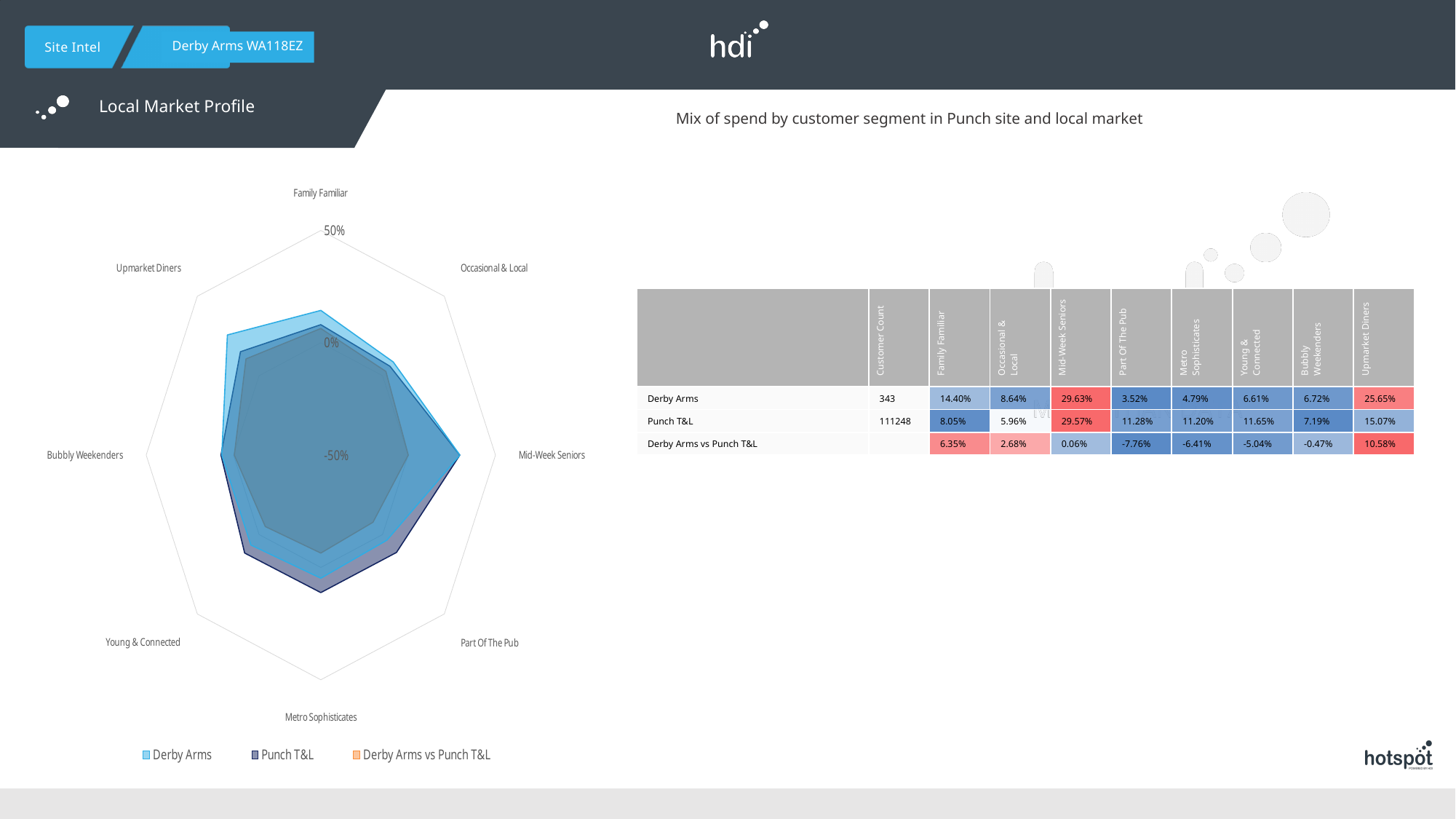
According to the table, what is the Derby Arms vs Punch T&L value for Part Of The Pub? -7.76% For Upmarket Diners, which is larger in the table: the Derby Arms value or the Punch T&L value? Derby Arms What is the highest axis tick value shown on the radar chart? 50% Which customer segment has the highest Derby Arms value in the table? Mid-Week Seniors Which series is shown in light blue in the radar chart legend? Derby Arms How many series does the legend of the radar chart list? 3 What kind of chart is shown on the left of the slide? Radar chart How many customer segment axes does the radar chart have? 8 According to the table, what is the Punch T&L value for Upmarket Diners? 15.07% According to the table, what is the Derby Arms value for Mid-Week Seniors? 29.63% What is the Customer Count for Punch T&L in the table? 111248 Which customer segment has the lowest Derby Arms value in the table? Part Of The Pub